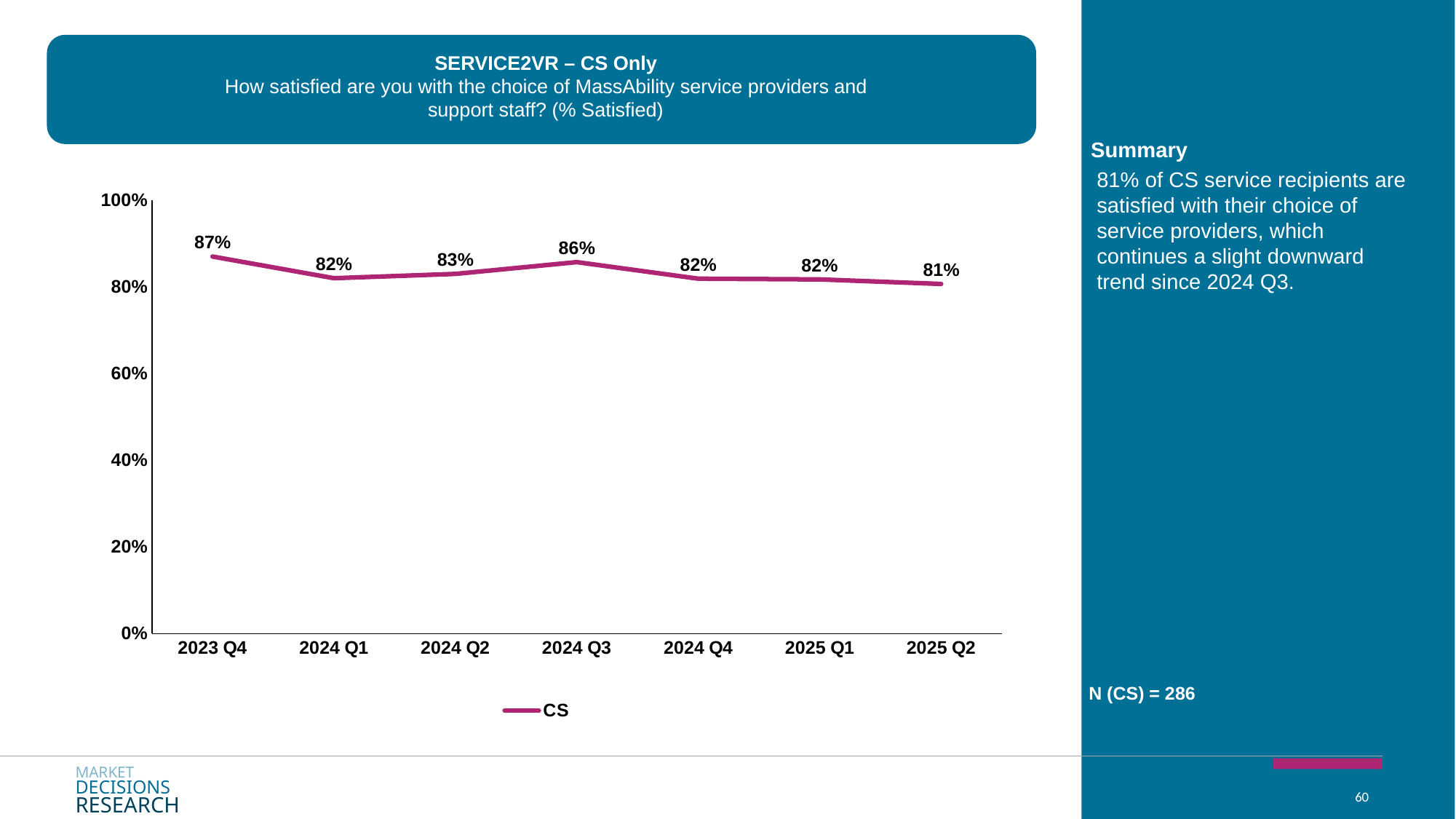
Which is larger, the value for 2024 Q3 or the value for 2024 Q4? 2024 Q3 Is the value for 2024 Q1 greater or less than 60%? greater What is the difference between the 2023 Q4 value and the 2025 Q2 value? 6 percentage points What is the % Satisfied value for 2024 Q3? 86% How many series does the legend list? 1 What is the % Satisfied value for 2025 Q2? 81% Which quarter has the lowest % Satisfied value? 2025 Q2 How many quarters are plotted on the x axis? 7 What kind of chart is shown on the slide? Line chart Which quarter has the highest % Satisfied value? 2023 Q4 Do the values rise or fall from 2024 Q3 to 2025 Q2? Fall What is the % Satisfied value for 2023 Q4? 87%